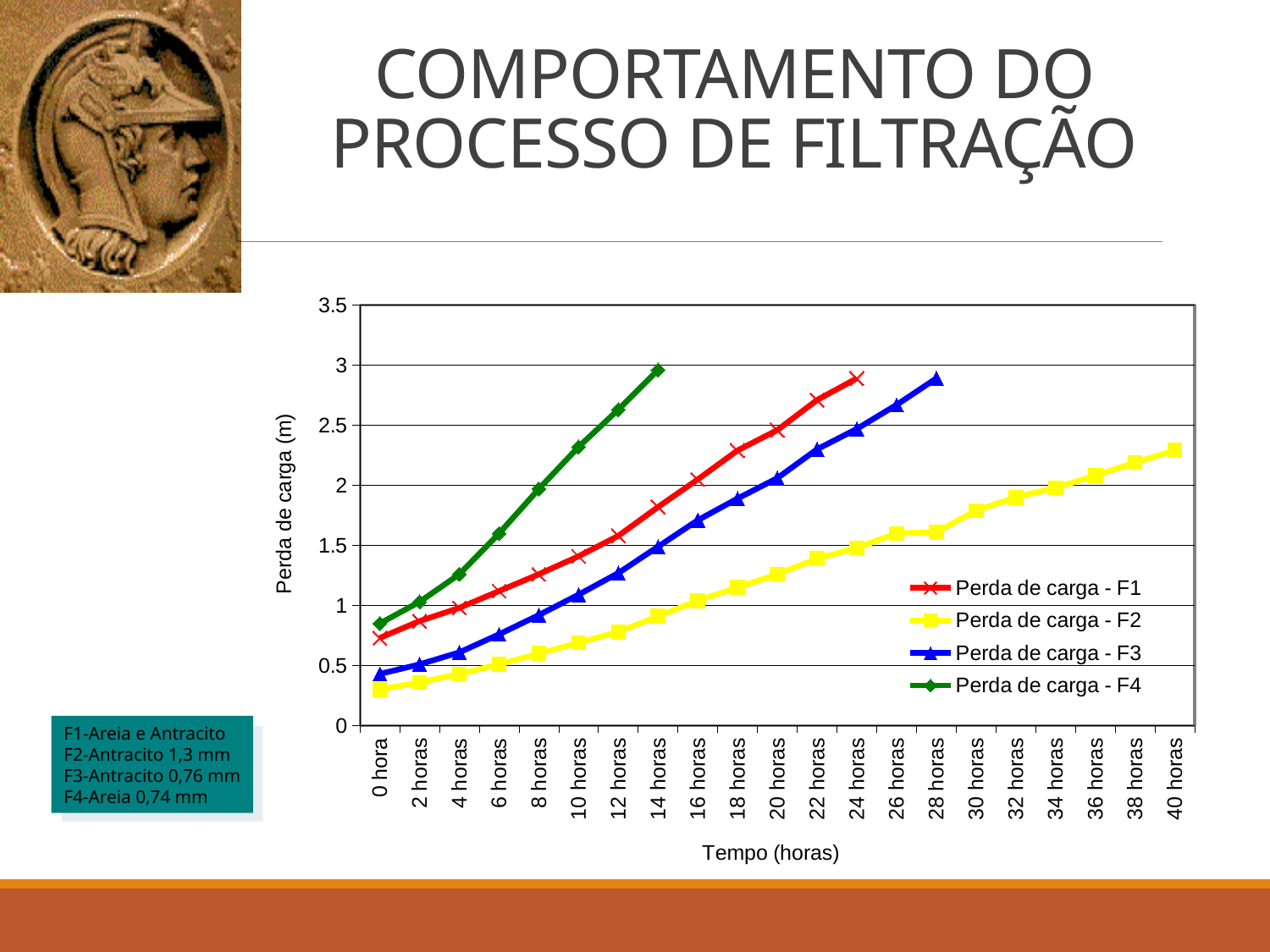
Is the value for Perda de carga - F4 at 14 horas greater or less than 2.5? greater Is the value for Perda de carga - F3 at 28 horas greater or less than 2.5? greater Is the value for Perda de carga - F1 at 0 hora greater or less than 1? less At 10 horas, which series has the larger value: Perda de carga - F4 or Perda de carga - F2? Perda de carga - F4 How many data points are plotted for Perda de carga - F4? 8 What kind of chart is shown on the slide? line chart How many series does the legend list? 4 How many time labels are shown along the x axis? 21 What is the label of the y axis? Perda de carga (m) At 20 horas, which series has the larger value: Perda de carga - F1 or Perda de carga - F3? Perda de carga - F1 Does the value of Perda de carga - F2 rise or fall as time increases along the x axis? rise